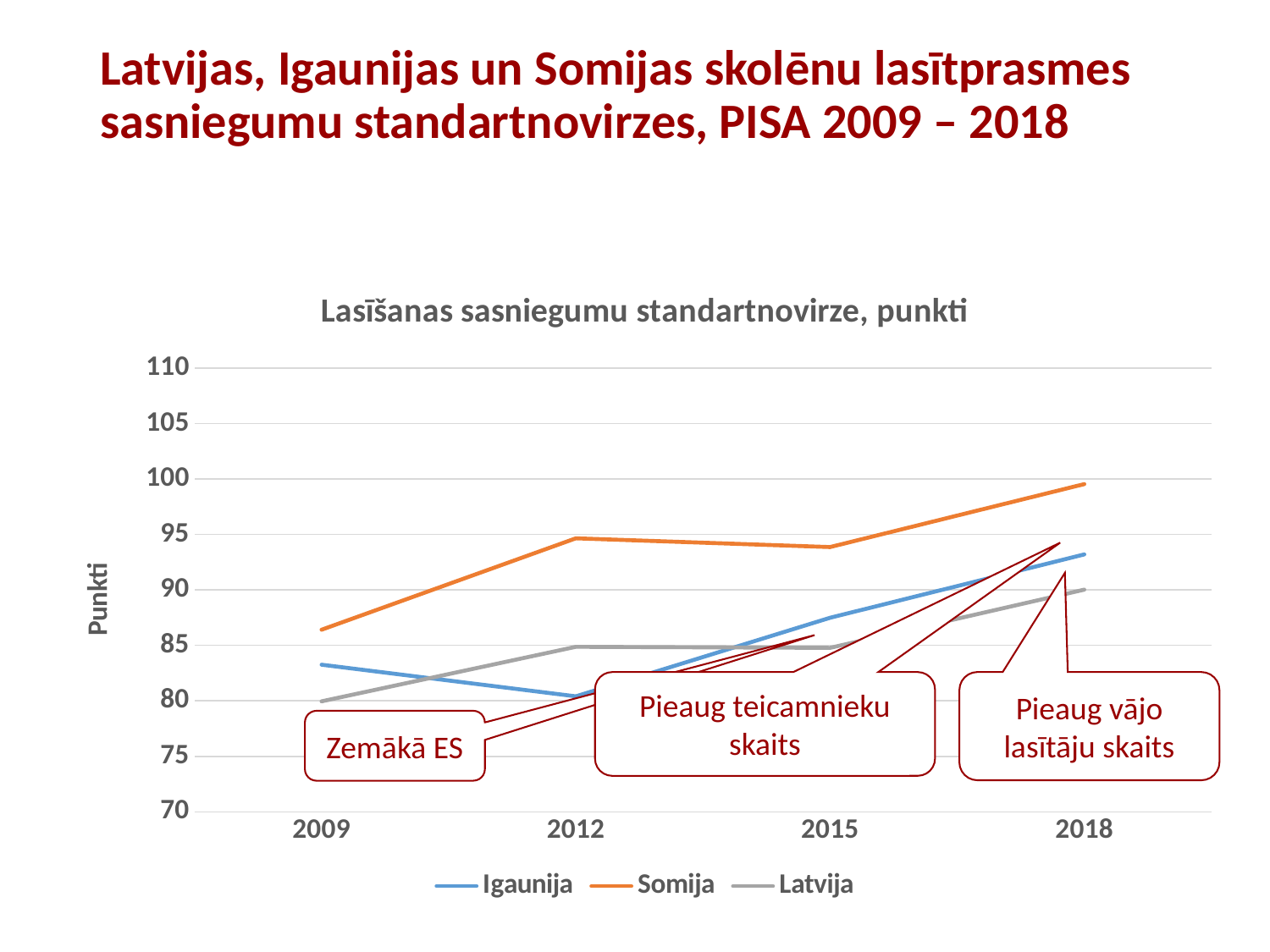
Which series has the highest value in 2018? Somija Is the value for Igaunija in 2012 greater or less than 85? less Which is larger in 2012, the value for Latvija or the value for Igaunija? Latvija Which series has the lowest value in 2009? Latvija How many series does the legend list? 3 Which is larger in 2009, the value for Somija or the value for Igaunija? Somija What is the label on the y axis of the chart? Punkti Is the value for Somija in 2018 greater or less than 95? greater How many years are shown on the x axis? 4 Does the value for Somija rise or fall from 2009 to 2018 overall? rise What kind of chart is shown on the slide? line chart Is the value for Latvija in 2009 greater or less than 85? less